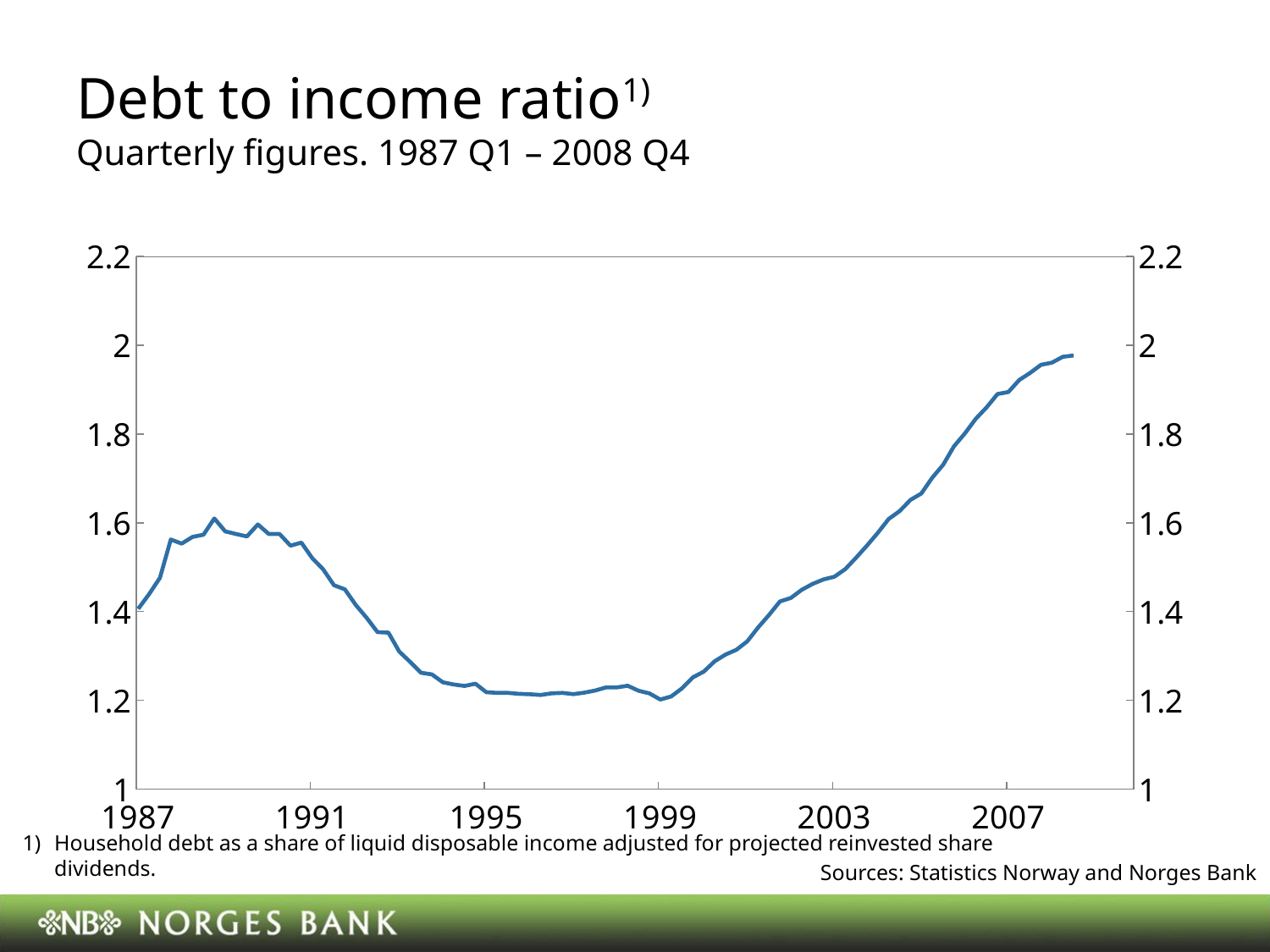
How many year labels are shown on the x axis? 6 What period does the chart cover according to the subtitle? 1987 Q1 – 2008 Q4 What is the title of the chart? Debt to income ratio Is the debt to income ratio in 1987 greater or less than 1.6? less Is the debt to income ratio in 2007 greater or less than 1.8? greater Which is larger, the debt to income ratio in 1987 or in 2007? 2007 Is the debt to income ratio in 1995 greater or less than 1.4? less What kind of chart is shown on the slide? line chart Does the debt to income ratio rise or fall between 1991 and 1995? fall Does the debt to income ratio rise or fall between 1999 and 2007? rise